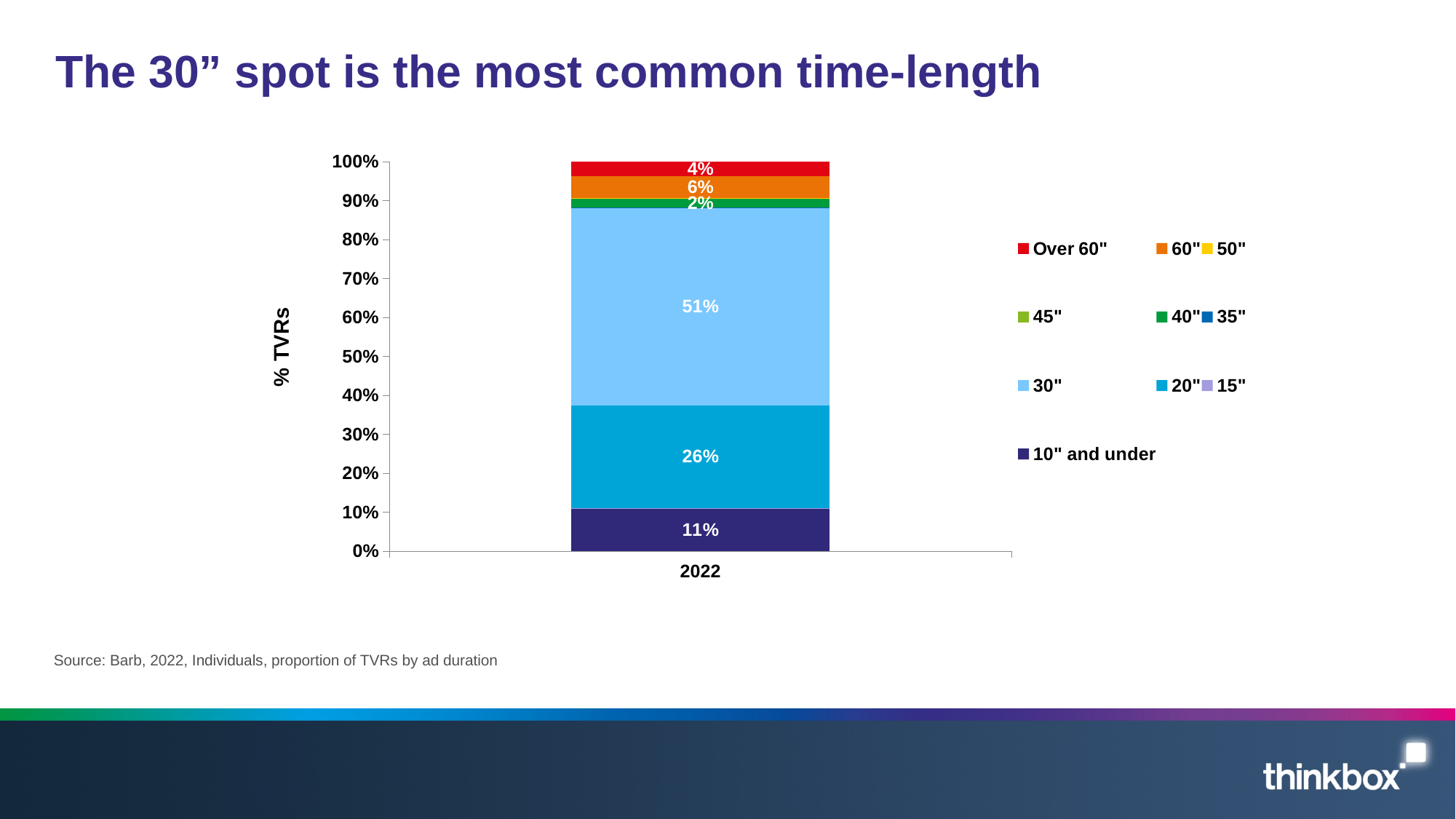
What is the value shown for the 60" segment? 6% What kind of chart is shown on the slide? Stacked bar chart Which is larger, the 20" segment or the 10" and under segment? 20" How many percentage points larger is the 30" segment than the 20" segment? 25% What is the difference between the 60" segment and the Over 60" segment? 2% What percentage of TVRs does the 30" segment account for in 2022? 51% What is the value shown for the 10" and under segment? 11% What is the label on the y axis? % TVRs What is the value shown for the 20" segment? 26% Which ad duration has the largest share of TVRs in the bar? 30" How many series does the legend list? 10 What is the value shown for the Over 60" segment? 4%